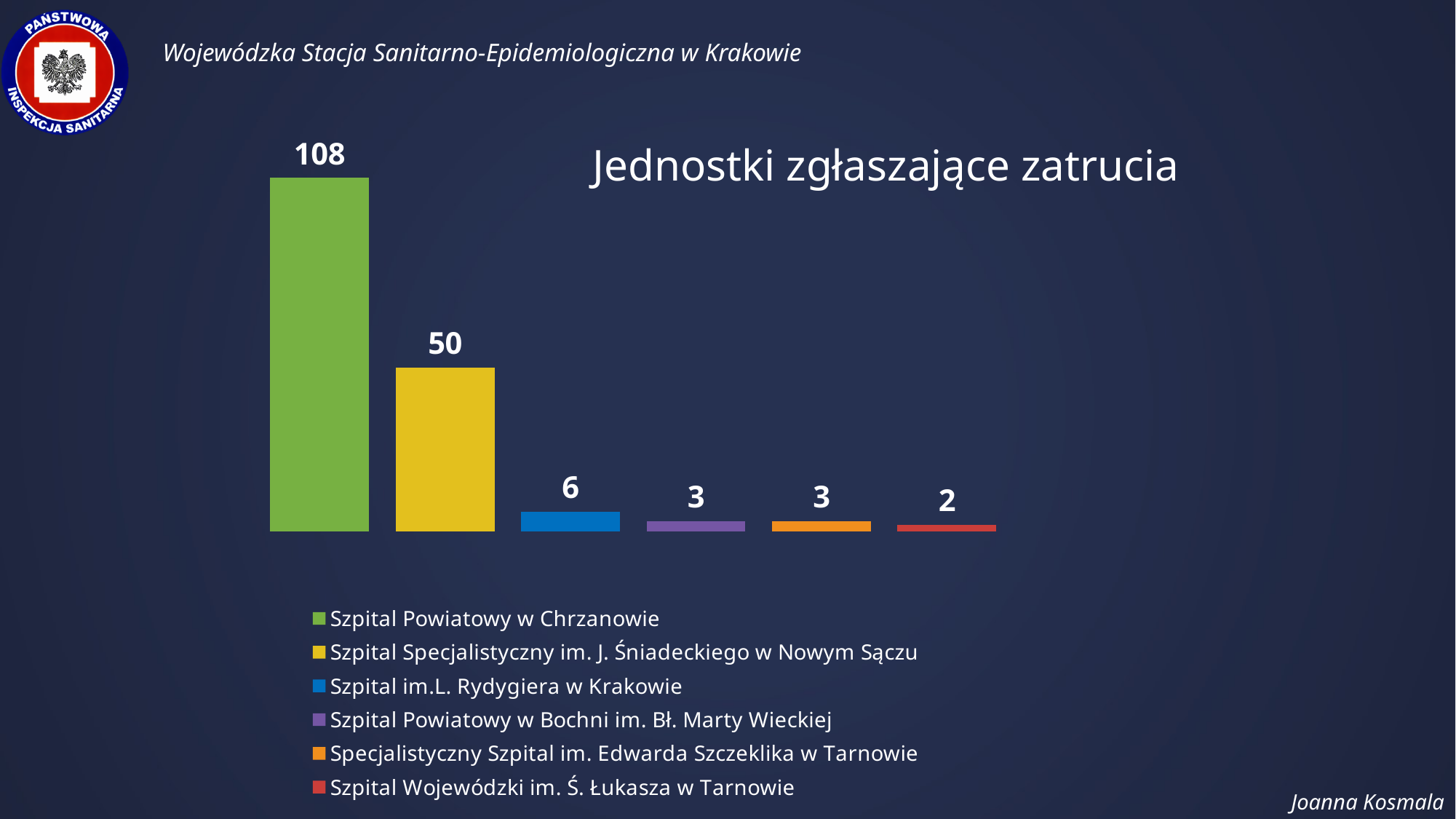
How many entries does the legend list? 6 How many bars are shown in the chart? 6 Which unit has the lowest value? Szpital Wojewódzki im. Ś. Łukasza w Tarnowie What kind of chart is shown on the slide? Bar chart Which is larger: the value for Szpital im.L. Rydygiera w Krakowie or for Szpital Powiatowy w Bochni im. Bł. Marty Wieckiej? Szpital im.L. Rydygiera w Krakowie Which unit has the highest value? Szpital Powiatowy w Chrzanowie What is the value for Szpital im.L. Rydygiera w Krakowie? 6 What is the difference between the values for Szpital Powiatowy w Chrzanowie and Szpital Specjalistyczny im. J. Śniadeckiego w Nowym Sączu? 58 What is the value for Szpital Powiatowy w Chrzanowie? 108 What is the title of the chart? Jednostki zgłaszające zatrucia What is the value for Szpital Specjalistyczny im. J. Śniadeckiego w Nowym Sączu? 50 What is the value for Szpital Wojewódzki im. Ś. Łukasza w Tarnowie? 2